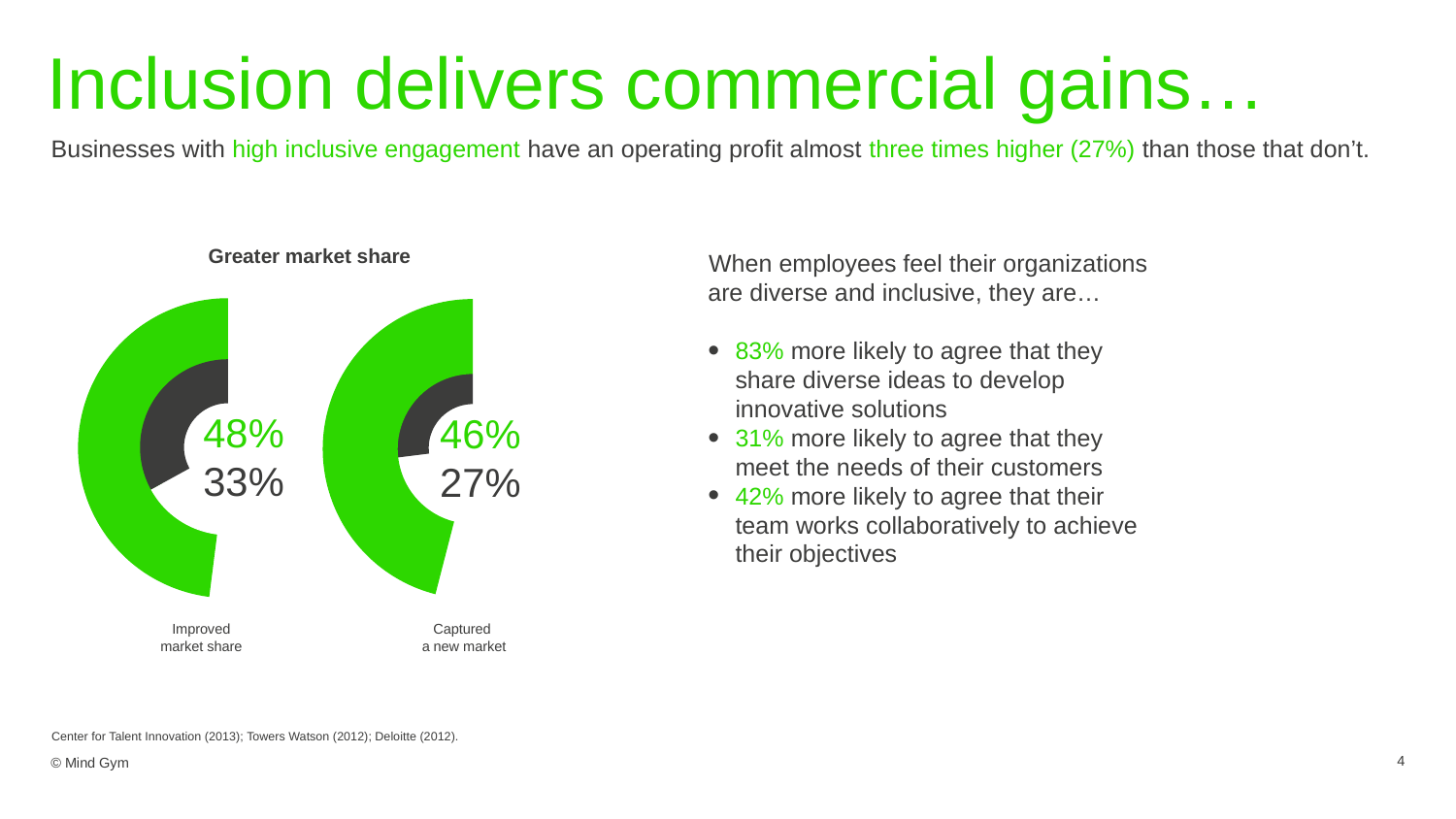
In the 'Greater market share' chart, what is the green value shown for 'Captured a new market'? 46% What is the title of the chart on the left side of the slide? Greater market share In the 'Greater market share' chart, which category has the higher green value: 'Improved market share' or 'Captured a new market'? Improved market share In the 'Greater market share' chart, what is the difference between the green and grey values for 'Improved market share'? 15% In the 'Greater market share' chart, what is the difference between the green and grey values for 'Captured a new market'? 19% In the 'Greater market share' chart, what is the grey value shown for 'Captured a new market'? 27% In the 'Greater market share' chart, which category has the lowest grey value? Captured a new market What kind of chart is used for 'Greater market share'? donut chart In the 'Greater market share' chart, which is larger for 'Captured a new market': the green value or the grey value? the green value In the 'Greater market share' chart, what is the green value shown for 'Improved market share'? 48% How many categories are shown in the 'Greater market share' chart? 2 In the 'Greater market share' chart, what is the grey value shown for 'Improved market share'? 33%